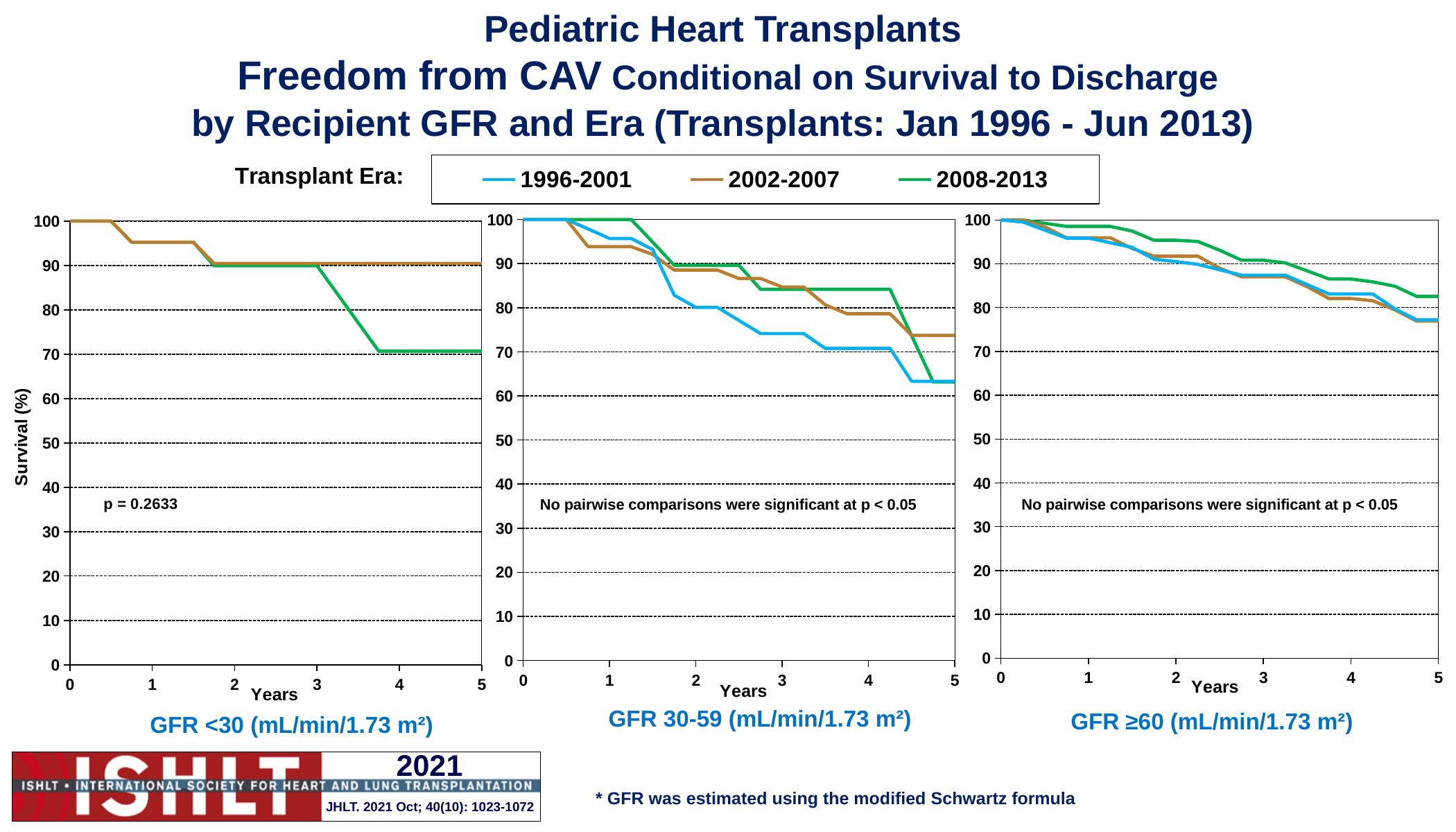
In the GFR 30-59 (mL/min/1.73 m²) chart, which era has the lowest value at 3 years? 1996-2001 In the GFR ≥60 (mL/min/1.73 m²) chart, is the value for 2008-2013 at 5 years greater or less than 80? greater How many transplant eras does the legend list? 3 In the GFR <30 (mL/min/1.73 m²) chart, is the value for 2008-2013 at 5 years greater or less than 80? less How many charts are shown on the slide? 3 In the GFR <30 (mL/min/1.73 m²) chart, does the 2008-2013 line rise or fall as years increase? fall What kind of chart is the GFR <30 (mL/min/1.73 m²) chart? line chart In the GFR ≥60 (mL/min/1.73 m²) chart, which era has the highest value at 5 years? 2008-2013 In the GFR 30-59 (mL/min/1.73 m²) chart, is the value for 1996-2001 at 5 years greater or less than 70? less What p-value is printed on the GFR <30 (mL/min/1.73 m²) chart? p = 0.2633